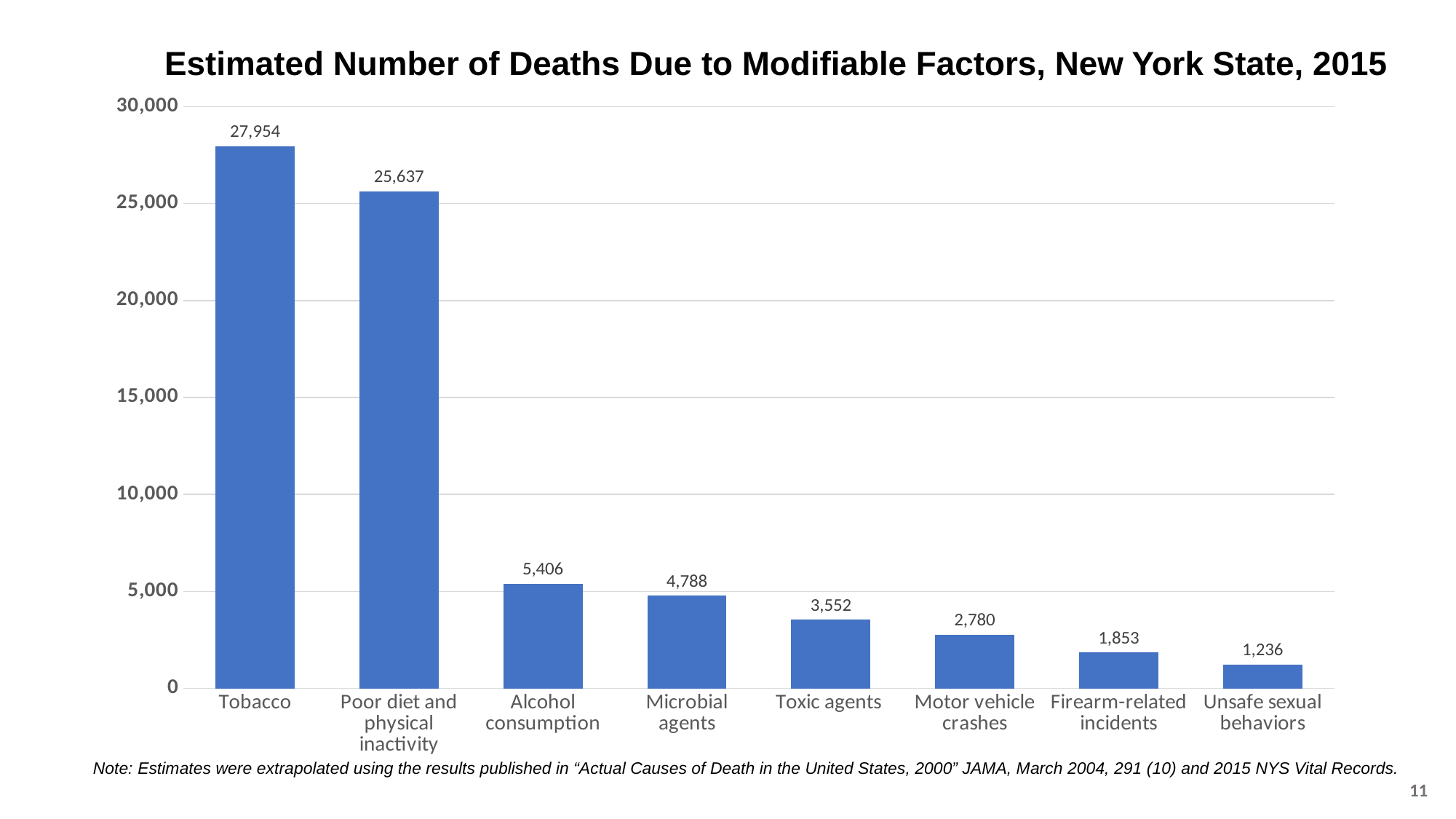
Do the values rise or fall from left to right across the categories? Fall Which has more estimated deaths, Microbial agents or Toxic agents? Microbial agents What is the estimated number of deaths due to Tobacco? 27,954 What is the estimated number of deaths due to Alcohol consumption? 5,406 What is the difference between the estimated deaths due to Tobacco and those due to Poor diet and physical inactivity? 2,317 Which modifiable factor has the lowest estimated number of deaths? Unsafe sexual behaviors Is the value for Firearm-related incidents greater or less than 5,000? less What is the estimated number of deaths due to Motor vehicle crashes? 2,780 What kind of chart is shown on the slide? Bar chart How many modifiable factors are shown on the chart? 8 What is the title of the chart? Estimated Number of Deaths Due to Modifiable Factors, New York State, 2015 Which modifiable factor has the highest estimated number of deaths? Tobacco